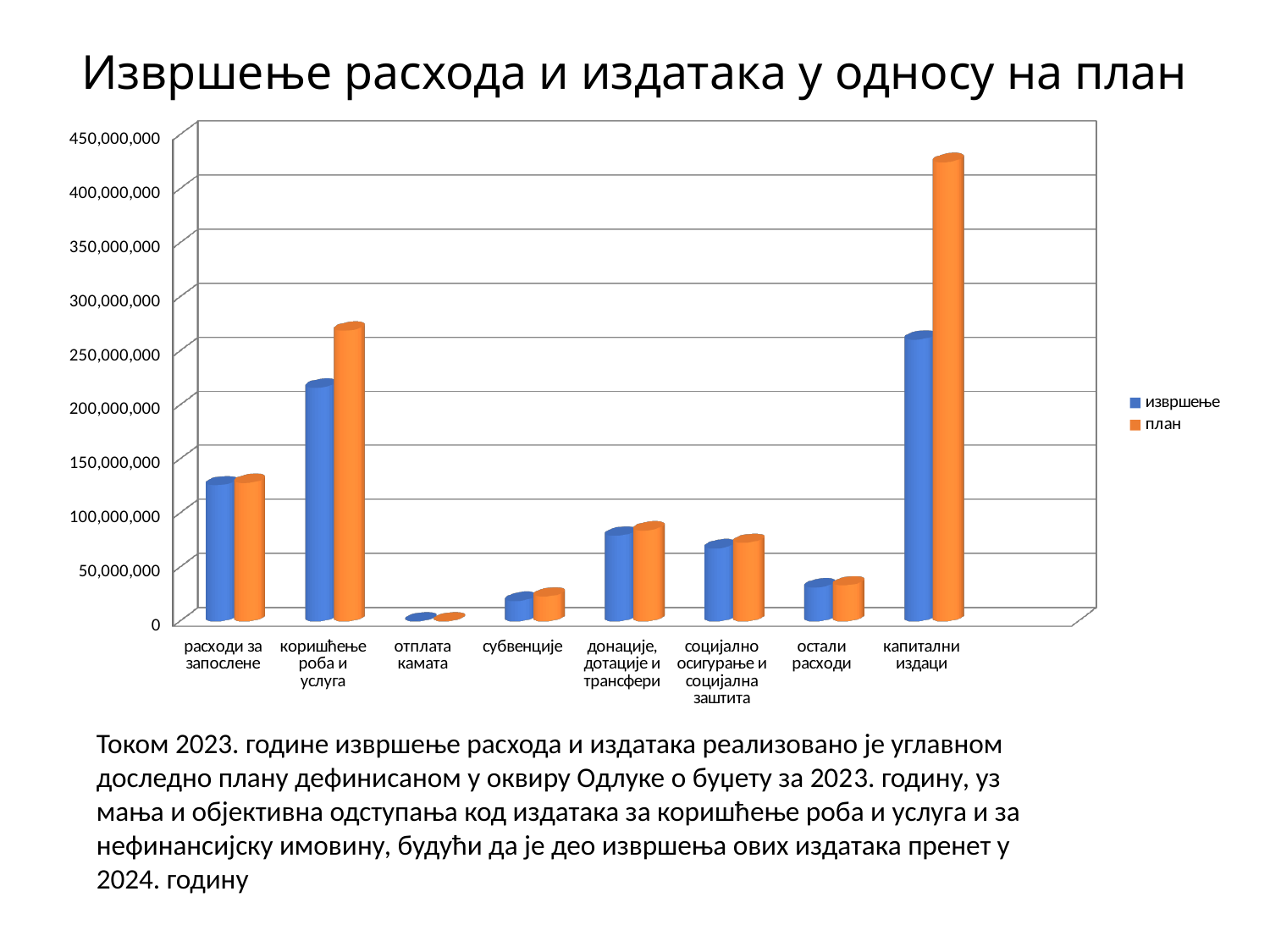
Which category has the highest value for the план series? капитални издаци Is the извршење value for коришћење роба и услуга greater or less than 250,000,000? less For капитални издаци, which is larger: извршење or план? план How many series does the legend list? 2 Which category has the highest value for the извршење series? капитални издаци What are the two series names listed in the legend? извршење and план Which category has the lowest value for the план series? отплата камата What kind of chart is shown on the slide? bar chart Is the извршење value for капитални издаци greater or less than 200,000,000? greater How many categories are shown on the x axis? 8 For коришћење роба и услуга, which is larger: извршење or план? план Is the план value for капитални издаци greater or less than 400,000,000? greater